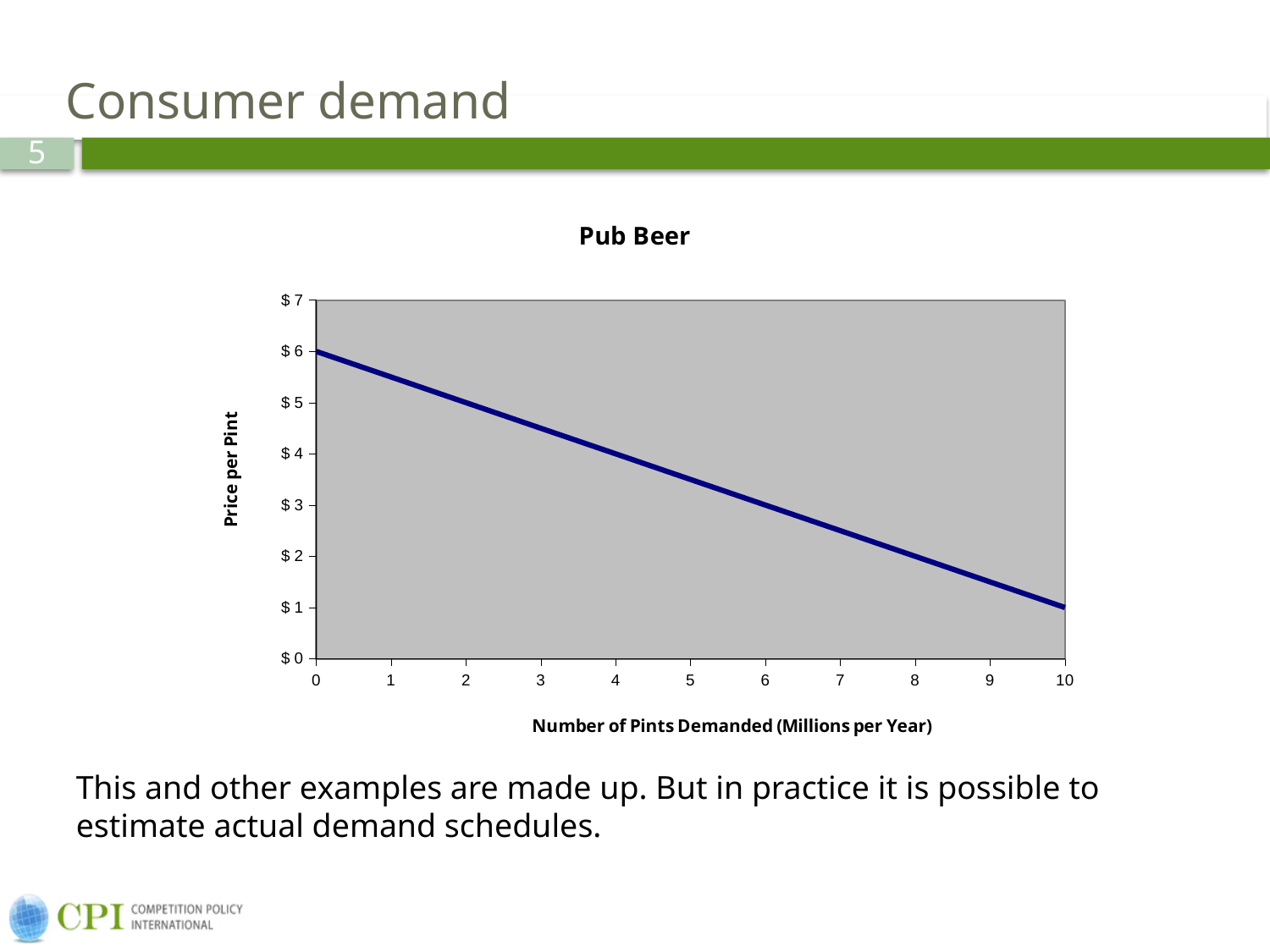
Is the price per pint at 9 million pints demanded greater or less than $ 2? less What is the price per pint when the number of pints demanded is 0? $ 6 What is the price per pint when the number of pints demanded is 10 million per year? $ 1 Which is higher: the price per pint at 0 pints demanded or at 10 million pints demanded? 0 pints demanded What is the difference between the price per pint at 0 pints demanded and at 10 million pints demanded? $ 5 Does the price per pint rise or fall as the number of pints demanded increases? fall What is the title of the chart? Pub Beer Is the price per pint at 1 million pints demanded greater or less than $ 5? greater What is the highest value shown on the y axis? $ 7 Is the price per pint at 5 million pints demanded greater or less than $ 5? less What kind of chart is shown on the slide? line chart What is the label of the y axis? Price per Pint